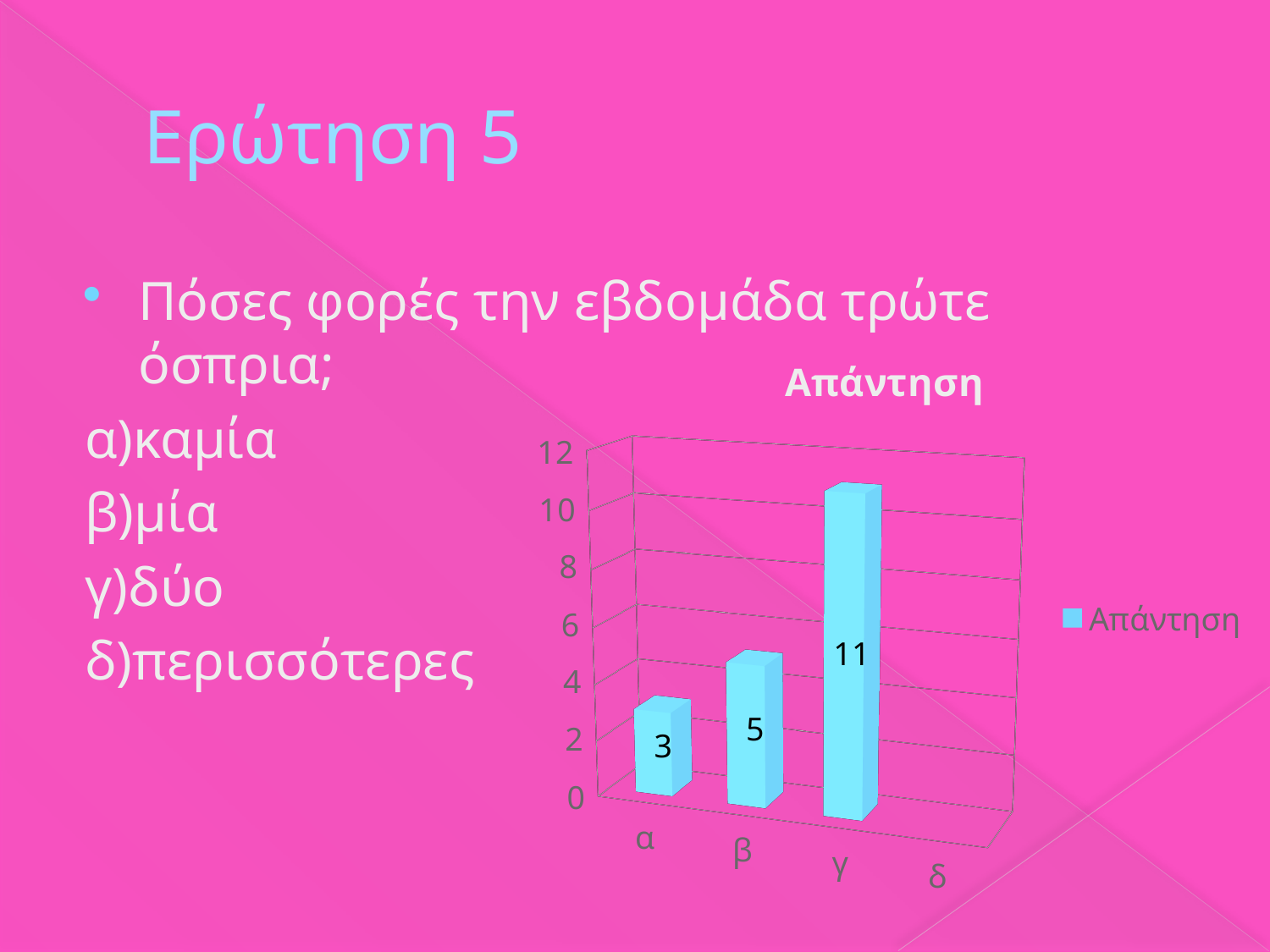
What is the difference between the values for β and α? 2 What is the value for category β? 5 What is the value for category α? 3 Which category has the highest value? γ How many series does the legend list? 1 What is the value for category γ? 11 How many categories are shown on the x axis? 4 Which is larger, the value for β or the value for γ? γ What is the difference between the values for γ and α? 8 What kind of chart is shown on the slide? bar chart What is the title of the chart? Απάντηση Is the value for γ greater or less than 10? greater